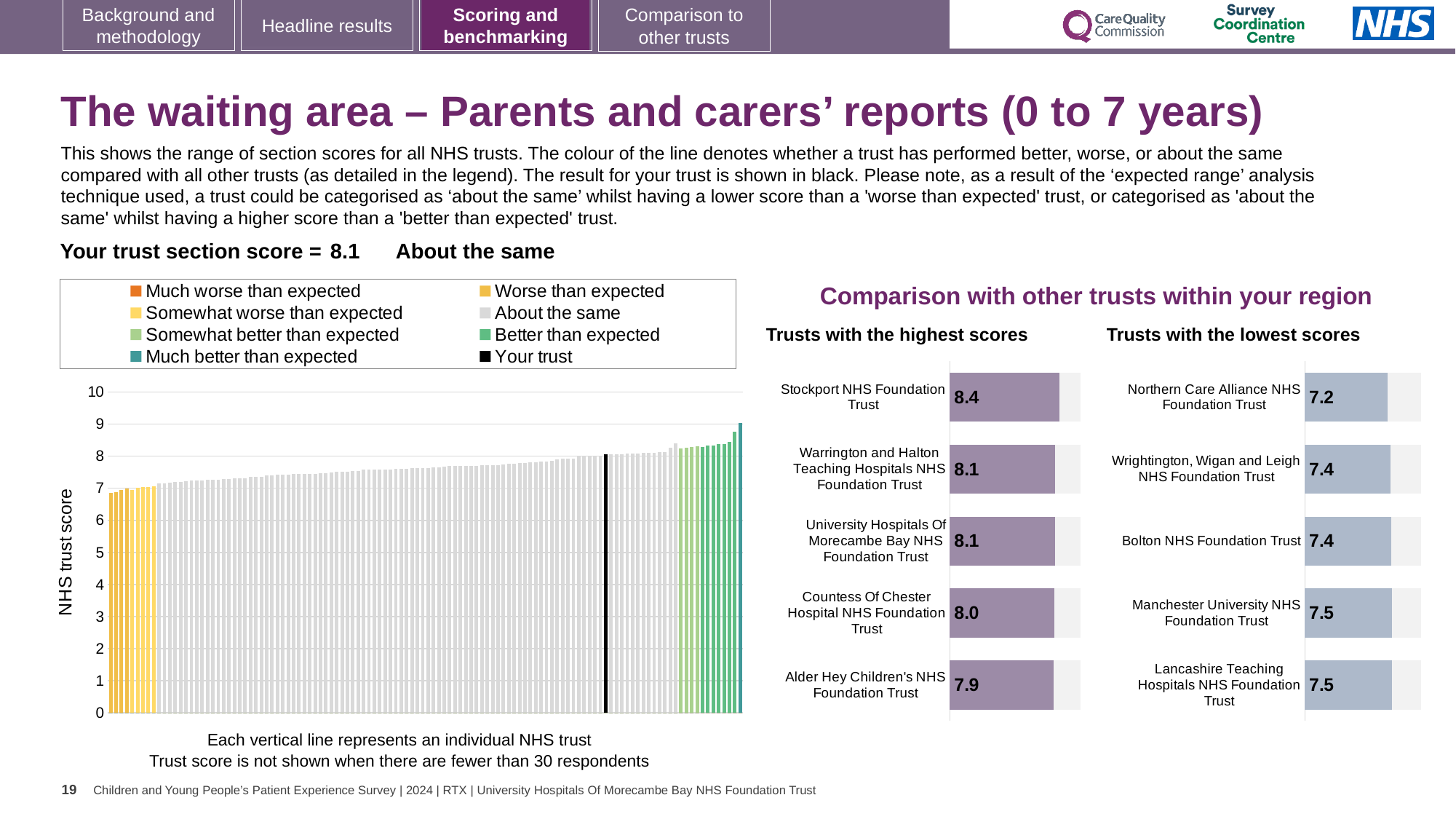
In the 'Trusts with the lowest scores' chart, what is the score for Bolton NHS Foundation Trust? 7.4 How many trusts are shown in the 'Trusts with the lowest scores' chart? 5 In the main NHS trust score chart on the left, do the values rise or fall from left to right? Rise In the 'Trusts with the lowest scores' chart, which trust has the lowest score? Northern Care Alliance NHS Foundation Trust In the 'Trusts with the lowest scores' chart, what is the score for Northern Care Alliance NHS Foundation Trust? 7.2 How many entries does the legend of the main NHS trust score chart list? 8 In the 'Trusts with the lowest scores' chart, which has the larger score: Northern Care Alliance NHS Foundation Trust or Manchester University NHS Foundation Trust? Manchester University NHS Foundation Trust In the 'Trusts with the highest scores' chart, what is the difference between the scores of Stockport NHS Foundation Trust and Alder Hey Children's NHS Foundation Trust? 0.5 What kind of chart is the main chart showing NHS trust scores on the left of the slide? Bar chart In the 'Trusts with the highest scores' chart, what is the score for Stockport NHS Foundation Trust? 8.4 In the 'Trusts with the highest scores' chart, what is the score for Alder Hey Children's NHS Foundation Trust? 7.9 In the 'Trusts with the highest scores' chart, which trust has the highest score? Stockport NHS Foundation Trust